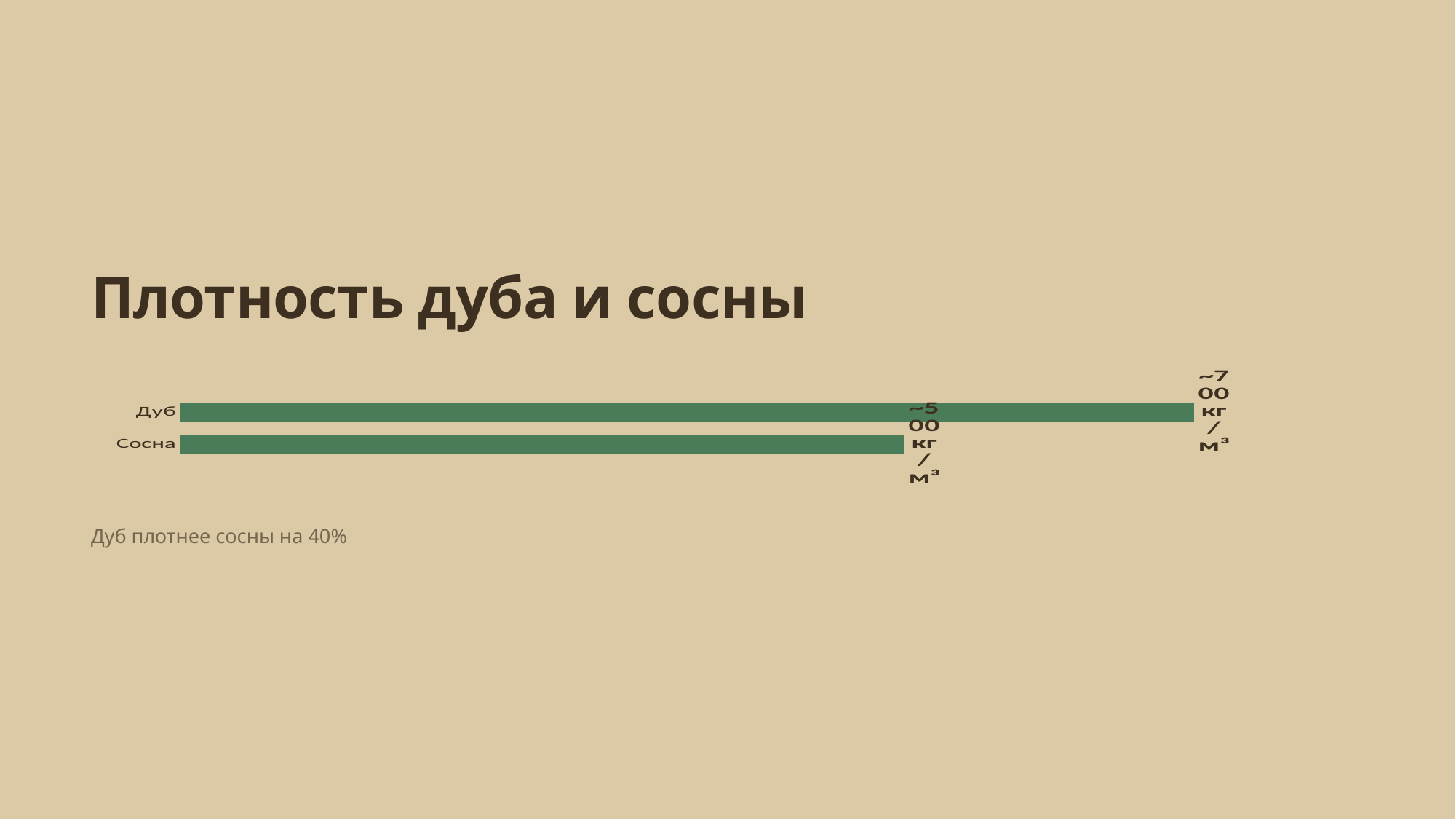
What colour are the bars in the chart? Green What value is labelled for Сосна? ~500 кг/м³ Which category has the lowest value? Сосна Which category has the highest value? Дуб What value is labelled for Дуб? ~700 кг/м³ What is the title of the chart on the slide? Плотность дуба и сосны Which is larger, the value for Дуб or the value for Сосна? Дуб What kind of chart is shown on the slide? Bar chart How many categories does the chart show? 2